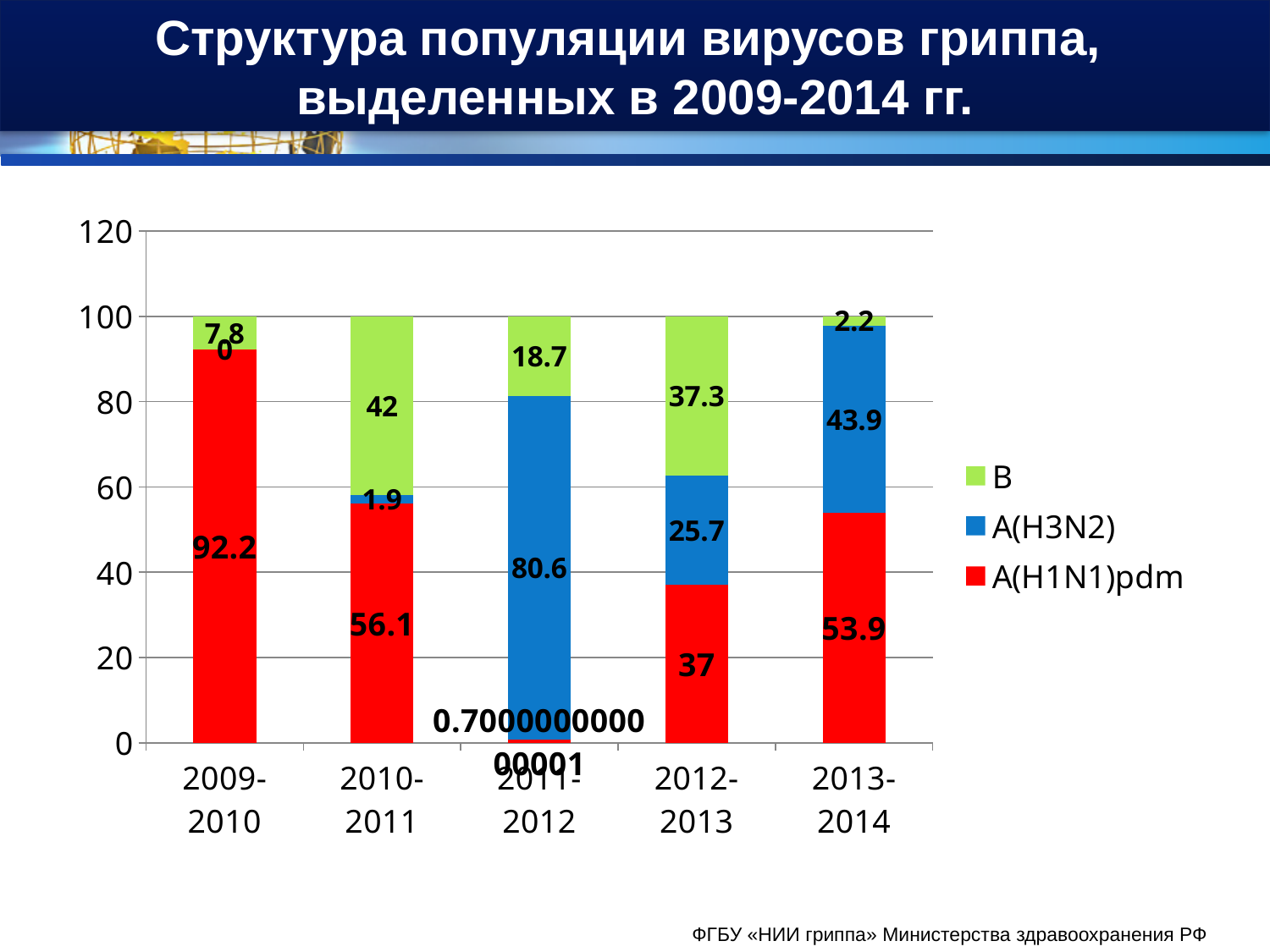
What is the total of the stacked bar for the 2012-2013 season? 100 In which season is the B value the lowest? 2013-2014 What is the value for A(H1N1)pdm in the 2009-2010 season? 92.2 In the 2010-2011 season, which is larger: A(H1N1)pdm or B? A(H1N1)pdm What is the value for A(H3N2) in the 2011-2012 season? 80.6 In which season is the A(H1N1)pdm value the highest? 2009-2010 What is the difference between the A(H1N1)pdm and A(H3N2) values in the 2013-2014 season? 10 What is the value for A(H3N2) in the 2013-2014 season? 43.9 What type of chart is shown on the slide? stacked bar chart How many seasons (categories) are shown on the x axis? 5 What is the value for B in the 2010-2011 season? 42 How many series does the legend list? 3